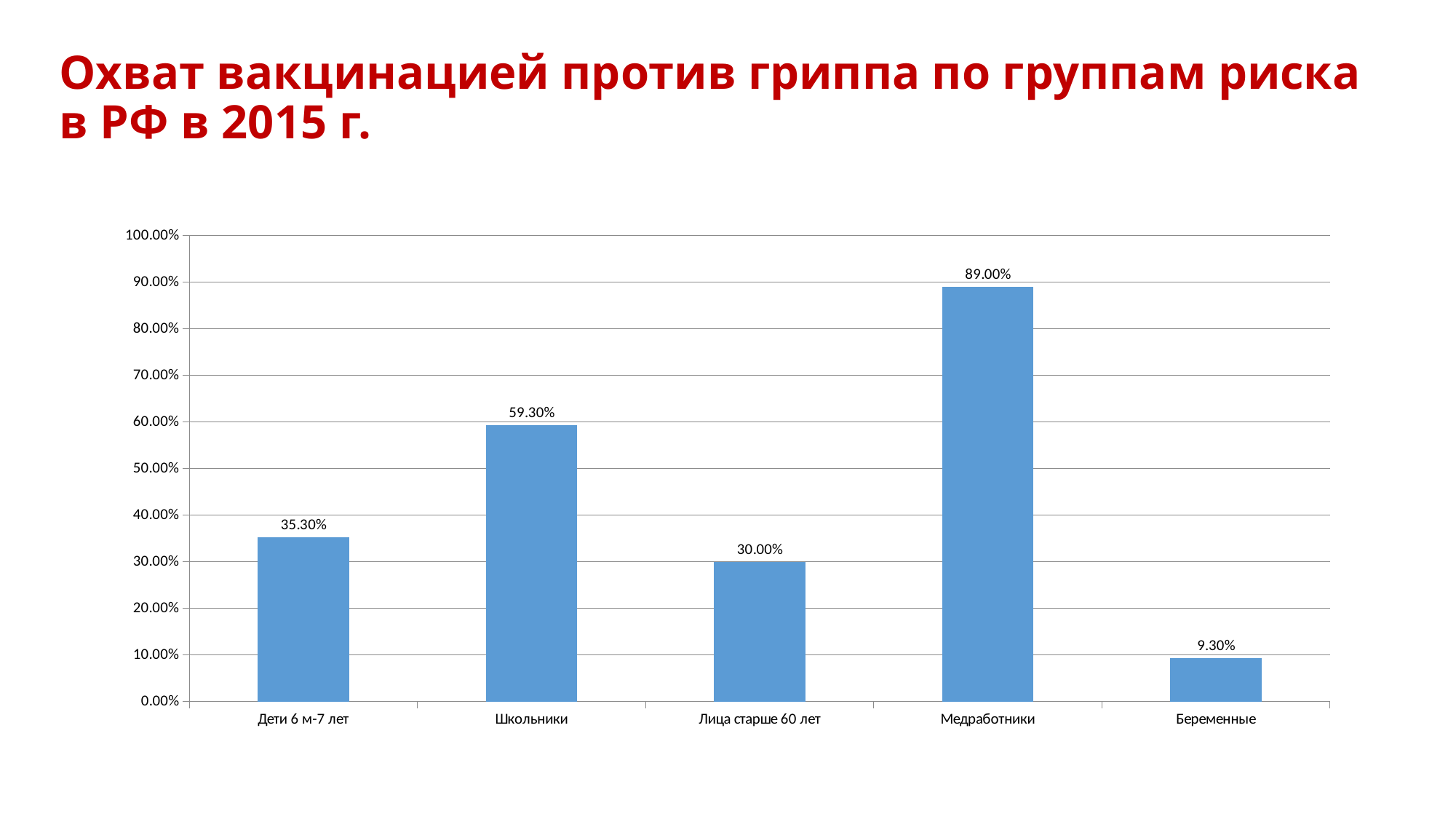
Which category has the lowest value? Беременные What is the difference between the values for Медработники and Школьники? 29.70% Which is larger, the value for Школьники or the value for Лица старше 60 лет? Школьники What is the value shown for Беременные? 9.30% Which category has the highest value? Медработники What is the value shown for Школьники? 59.30% Is the value for Лица старше 60 лет greater or less than 40.00%? less How many categories are shown on the x axis? 5 What is the difference between the values for Дети 6 м-7 лет and Лица старше 60 лет? 5.30% What kind of chart is shown on the slide? bar chart What is the value shown for Дети 6 м-7 лет? 35.30% What is the vaccination coverage value for Медработники? 89.00%